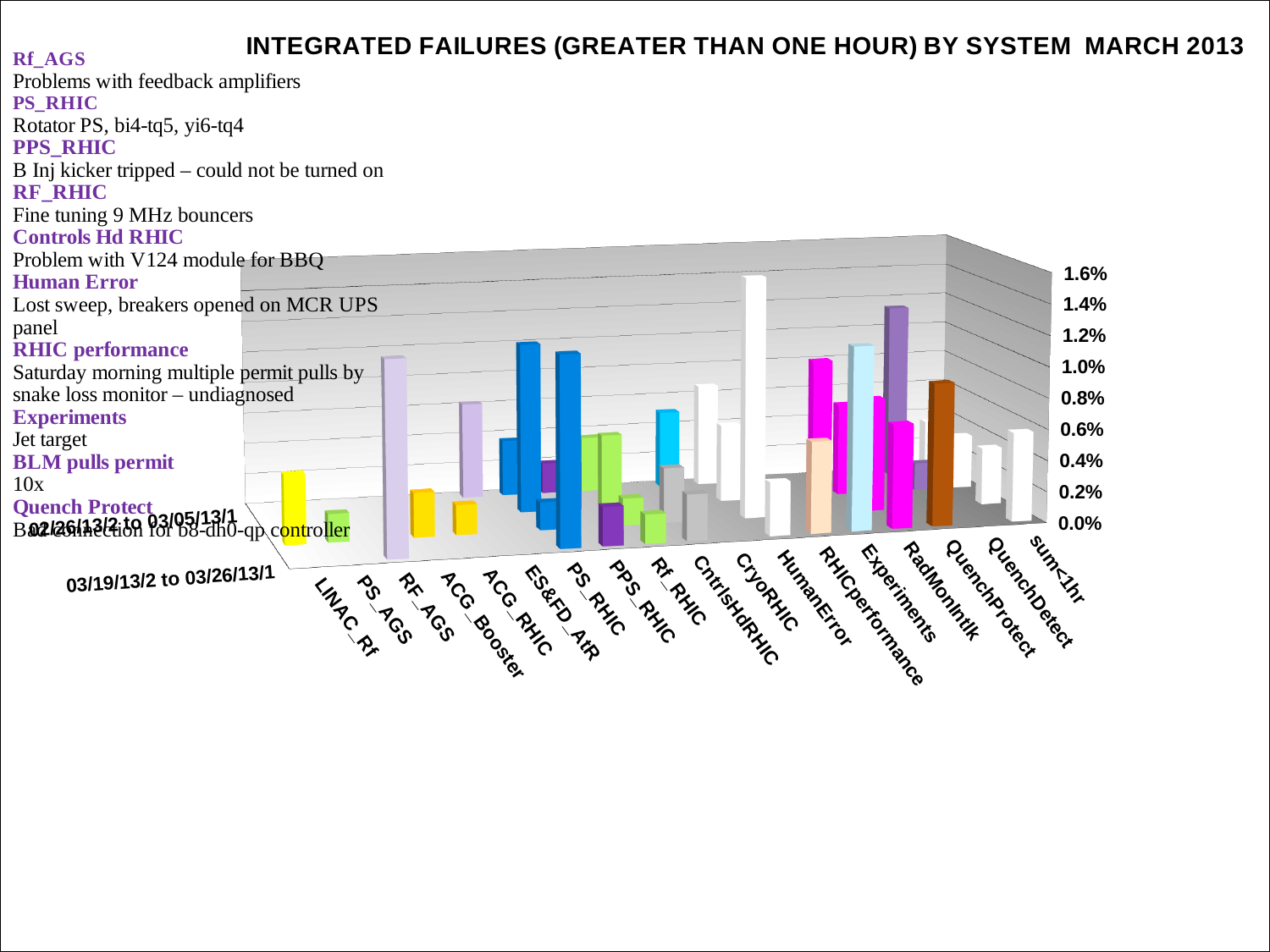
What kind of chart is shown on the slide? bar chart What is the last category label on the x axis of the chart? sum<1hr What is the first category label on the x axis of the chart? LINAC_Rf What is the step between consecutive tick marks on the vertical axis of the chart? 0.2% What is the title of the chart? INTEGRATED FAILURES (GREATER THAN ONE HOUR) BY SYSTEM MARCH 2013 What is the highest tick value shown on the vertical axis of the chart? 1.6% How many system categories are listed along the x axis of the chart? 18